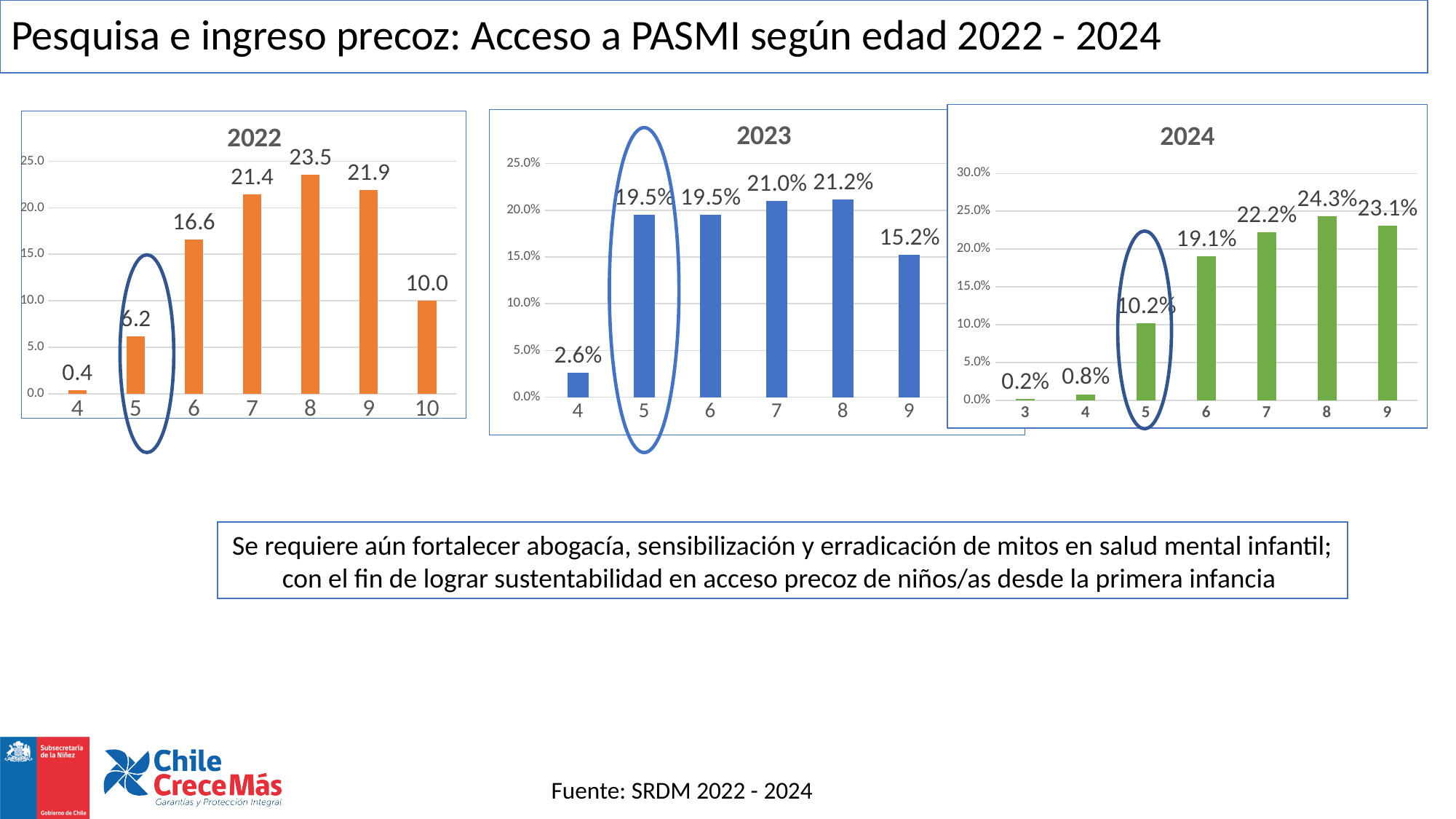
In the 2022 chart, what is the difference between the values for age 8 and age 4? 23.1 In the 2022 chart, what is the value for age 5? 6.2 In the 2022 chart, how many age categories are shown on the x axis? 7 In the 2024 chart, which age has the highest value? 8 In the 2024 chart, how many age categories are shown on the x axis? 7 In the 2024 chart, what is the value for age 5? 10.2% In the 2024 chart, what is the difference between the values for age 6 and age 5? 8.9% In the 2023 chart, which age has the lowest value? 4 What type of chart is the 2023 chart? bar chart In the 2023 chart, which is larger, the value for age 7 or the value for age 9? age 7 In the 2022 chart, which age has the highest value? 8 In the 2023 chart, what is the value for age 9? 15.2%